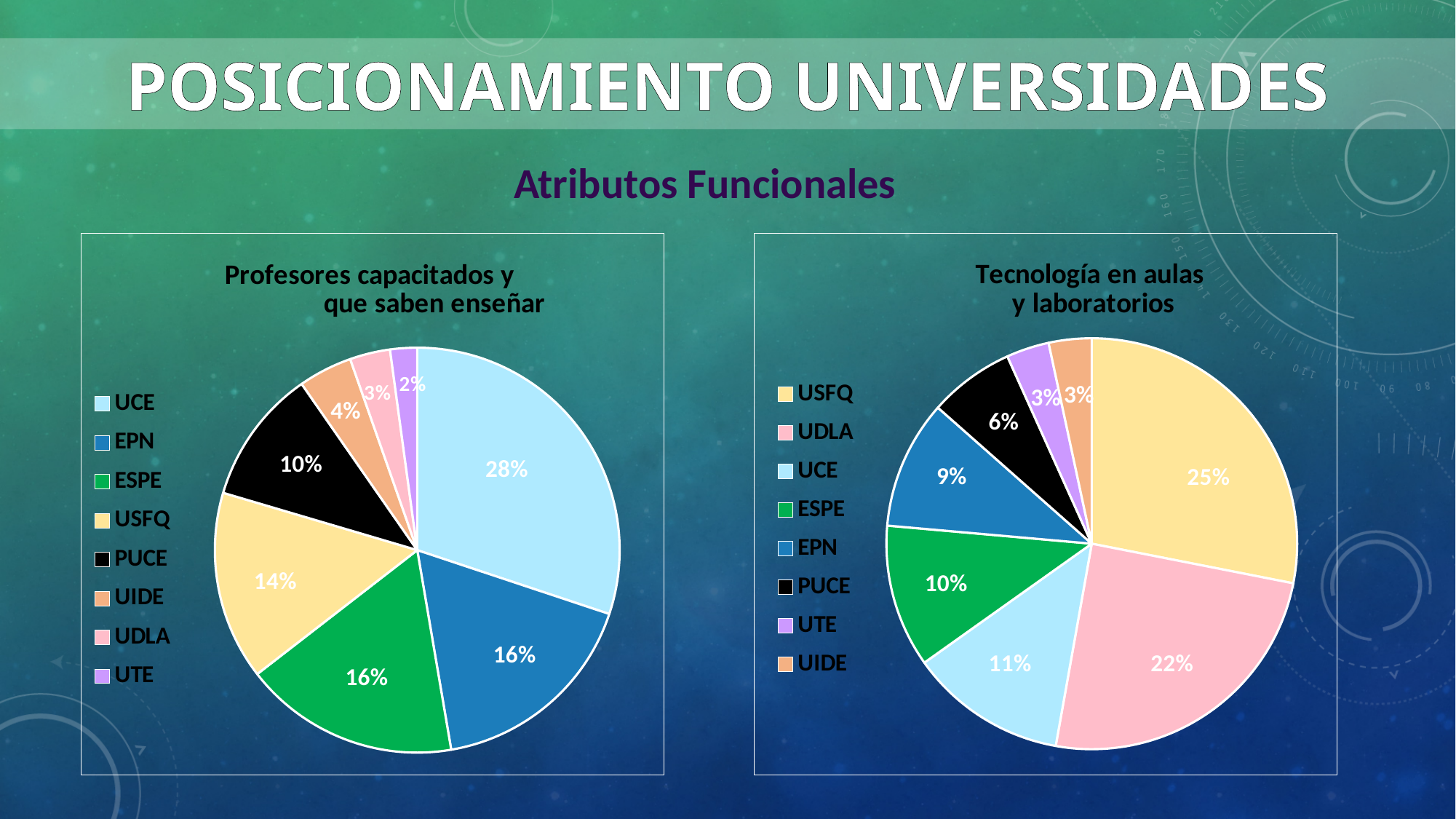
In the 'Profesores capacitados y que saben enseñar' chart, what is the difference between the UCE and USFQ shares? 14% In the 'Tecnología en aulas y laboratorios' chart, which is larger, the share for UCE or the share for EPN? UCE In the 'Tecnología en aulas y laboratorios' chart, what share does UDLA have? 22% In the 'Tecnología en aulas y laboratorios' chart, what share does PUCE have? 6% What is the subtitle shown above the two charts? Atributos Funcionales What type of chart is used for 'Tecnología en aulas y laboratorios'? Pie chart In the 'Profesores capacitados y que saben enseñar' chart, which university has the smallest slice? UTE In the 'Profesores capacitados y que saben enseñar' chart, what share does UCE have? 28% In the 'Tecnología en aulas y laboratorios' chart, what is the difference between the USFQ and UDLA shares? 3% In the 'Profesores capacitados y que saben enseñar' chart, how many universities are listed in the legend? 8 In the 'Tecnología en aulas y laboratorios' chart, which university has the largest slice? USFQ In the 'Profesores capacitados y que saben enseñar' chart, what share does PUCE have? 10%